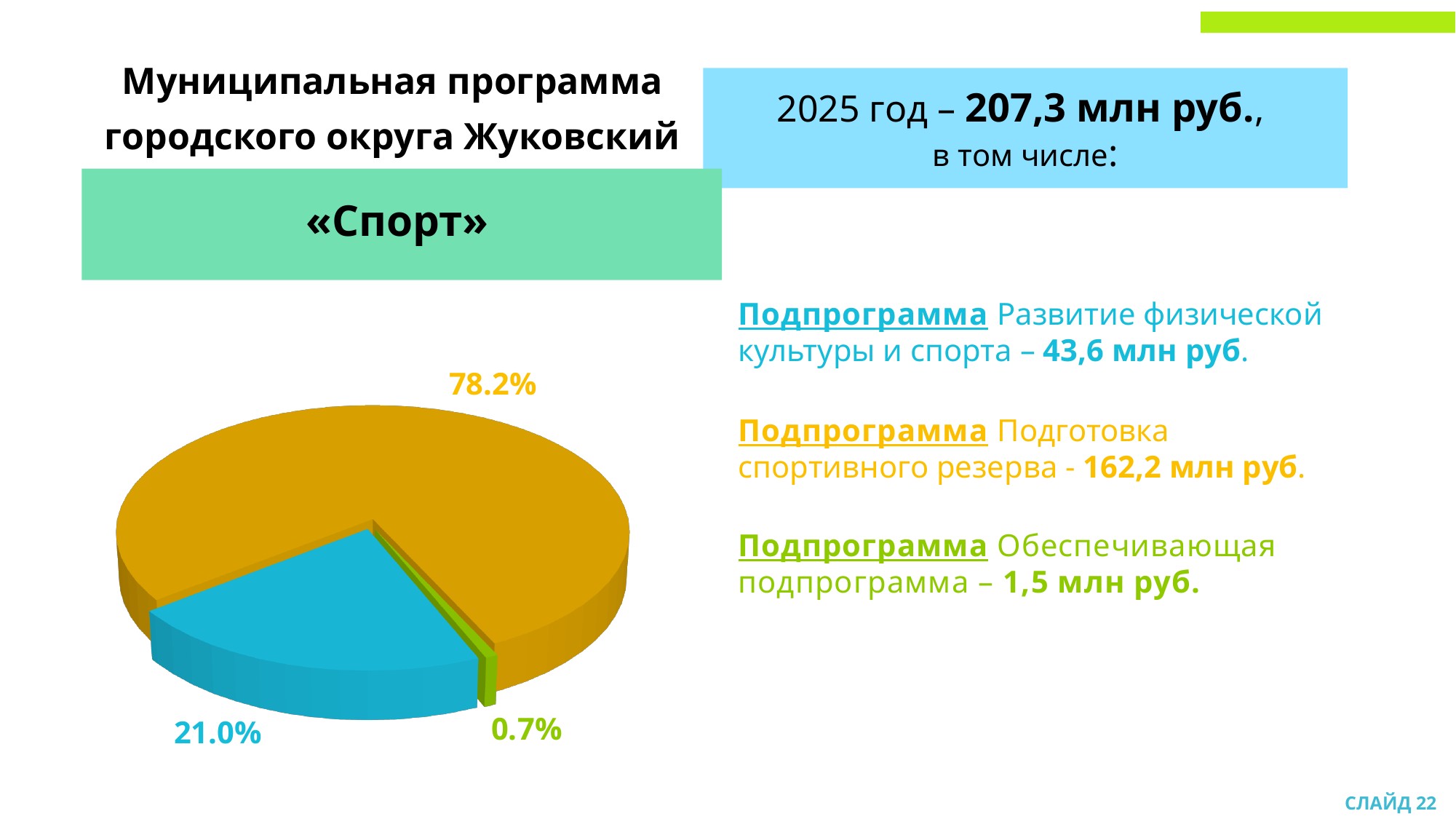
What share of the pie corresponds to the subprogram «Подготовка спортивного резерва» (shown in orange)? 78.2% What share of the pie does the blue slice represent? 21.0% Which slice of the pie chart is the smallest? 0.7% (green) What share of the pie corresponds to the subprogram «Развитие физической культуры и спорта» (shown in blue)? 21.0% Which is larger, the blue slice or the green slice? the blue slice What kind of chart is shown on the slide? pie chart What is the difference in percentage points between the orange slice (78.2%) and the blue slice (21.0%)? 57.2 What colour is the slice labelled 0.7%? green Which slice of the pie chart is the largest? 78.2% (orange) How many slices does the pie chart have? 3